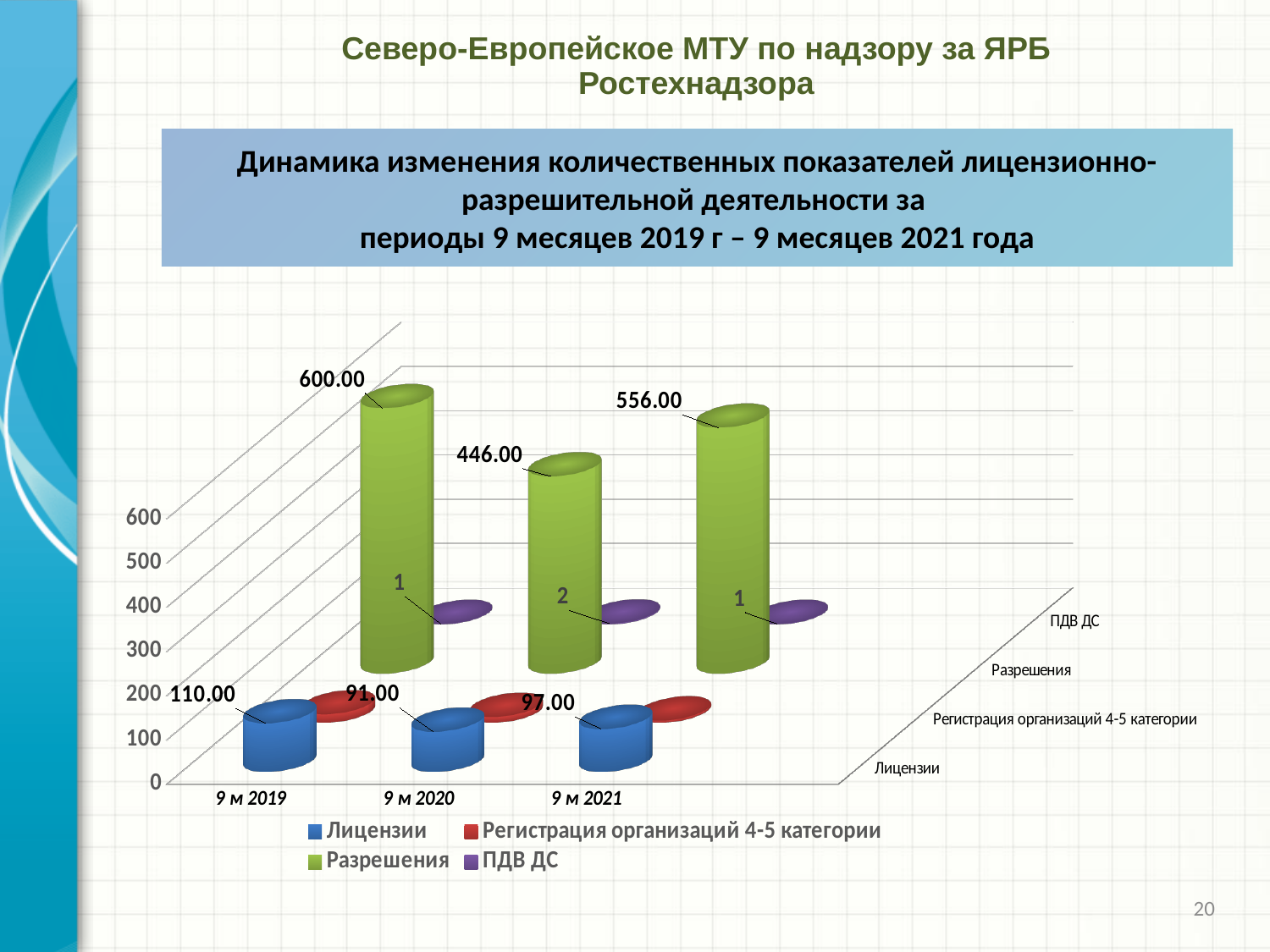
In which period is the value of Разрешения highest? 9 м 2019 What is the difference between the Разрешения values for 9 м 2019 and 9 м 2020? 154.00 What is the value of Разрешения for 9 м 2020? 446.00 What is the value of ПДВ ДС for 9 м 2020? 2 How many periods are shown on the x axis? 3 What kind of chart is shown on the slide? bar chart Which period has the larger Лицензии value, 9 м 2020 or 9 м 2021? 9 м 2021 What is the value of Лицензии for 9 м 2019? 110.00 What is the value of Разрешения for 9 м 2019? 600.00 How many series does the legend list? 4 In which period is the value of Разрешения lowest? 9 м 2020 What colour represents the Разрешения series in the legend? green